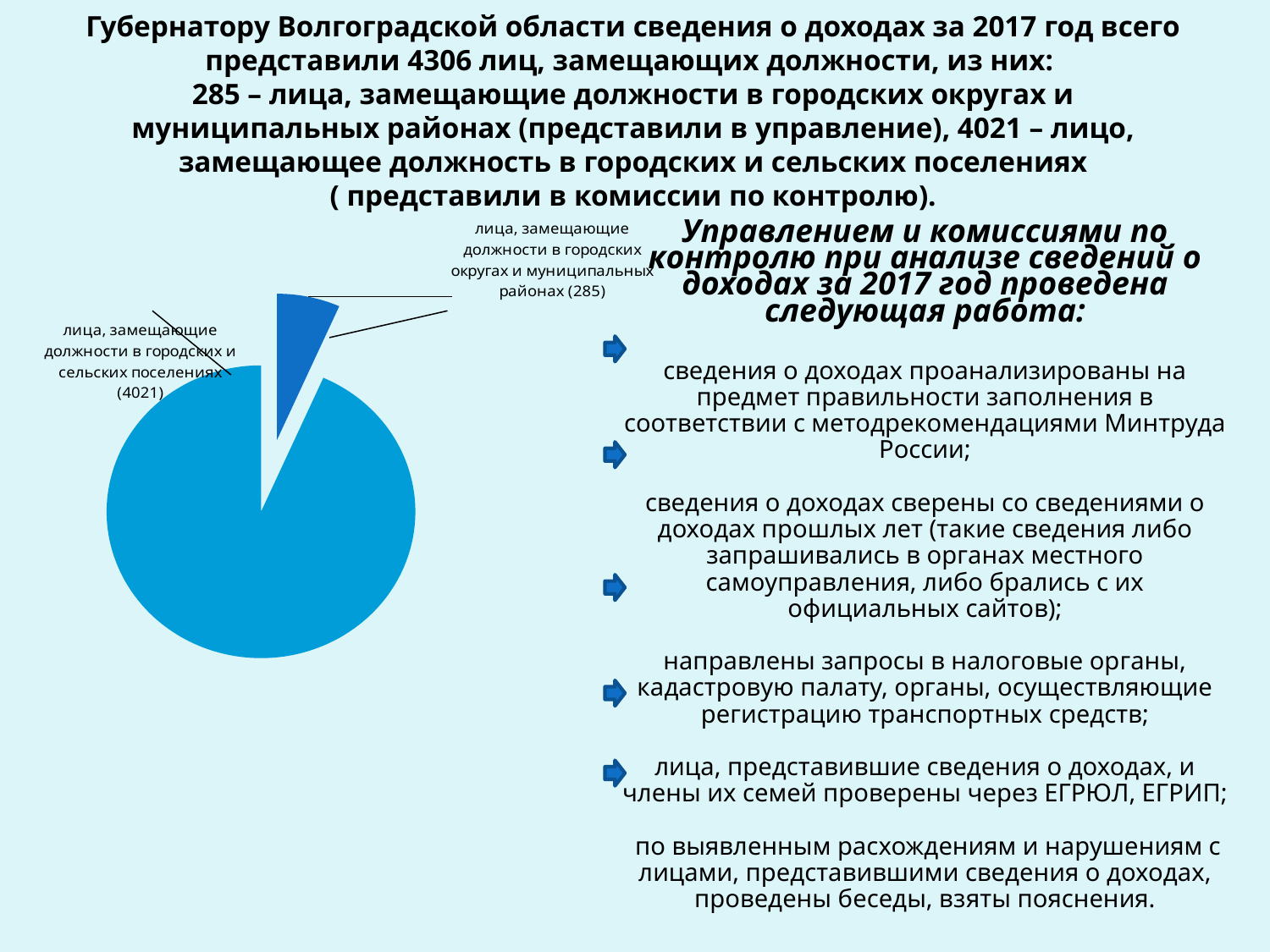
Which is larger: the slice for городские и сельские поселения or the slice for городские округа и муниципальные районы? городские и сельские поселения Which category has the smallest slice in the pie chart? лица, замещающие должности в городских округах и муниципальных районах Is the value for the slice 'городские округа и муниципальные районы' greater or less than 1000? less What is the difference between the number of persons in urban and rural settlements (4021) and those in city districts and municipal areas (285)? 3736 Which slice of the pie chart is drawn in the darker blue colour? лица, замещающие должности в городских округах и муниципальных районах (285) What is the total number of persons represented by the two slices of the pie chart? 4306 What value is shown for the slice labelled 'лица, замещающие должности в городских округах и муниципальных районах'? 285 What type of chart is shown on the slide? pie chart For which year are the income data in the pie chart reported? 2017 What value is shown for the slice labelled 'лица, замещающие должности в городских и сельских поселениях'? 4021 How many slices does the pie chart have? 2 Which category has the largest slice in the pie chart? лица, замещающие должности в городских и сельских поселениях